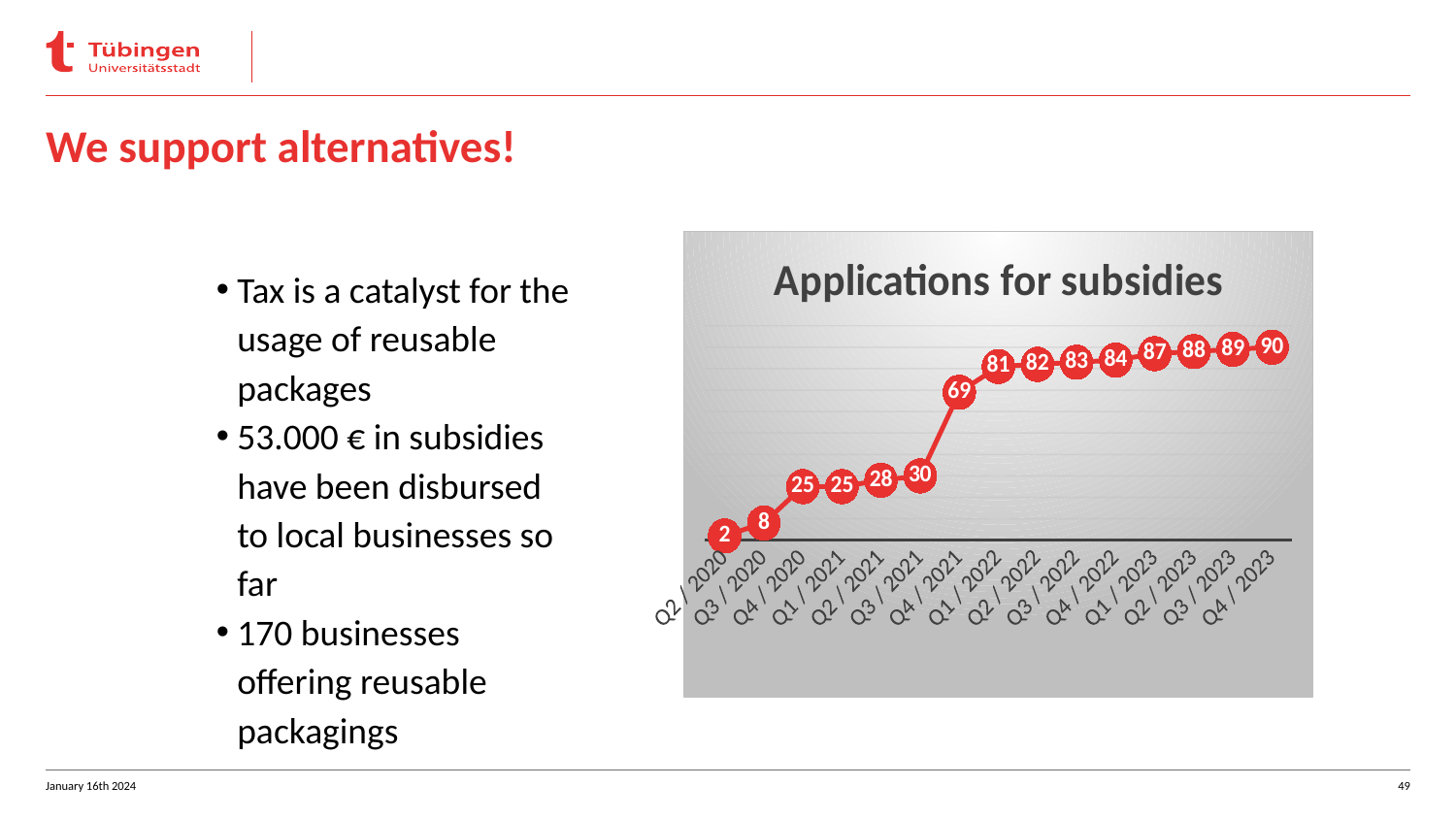
Which quarter has the highest value? Q4 / 2023 What is the value for Q3 / 2021? 30 What is the value for Q2 / 2020? 2 Which quarter has the lowest value? Q2 / 2020 What is the value for Q4 / 2021? 69 How many data points are plotted on the chart? 15 What is the title of the chart? Applications for subsidies What is the difference between the values for Q4 / 2021 and Q3 / 2021? 39 Which is larger, the value for Q1 / 2022 or the value for Q3 / 2021? Q1 / 2022 What is the difference between the values for Q4 / 2023 and Q2 / 2020? 88 Do the values rise or fall from Q2 / 2020 to Q4 / 2023? rise What kind of chart is shown on the slide? line chart